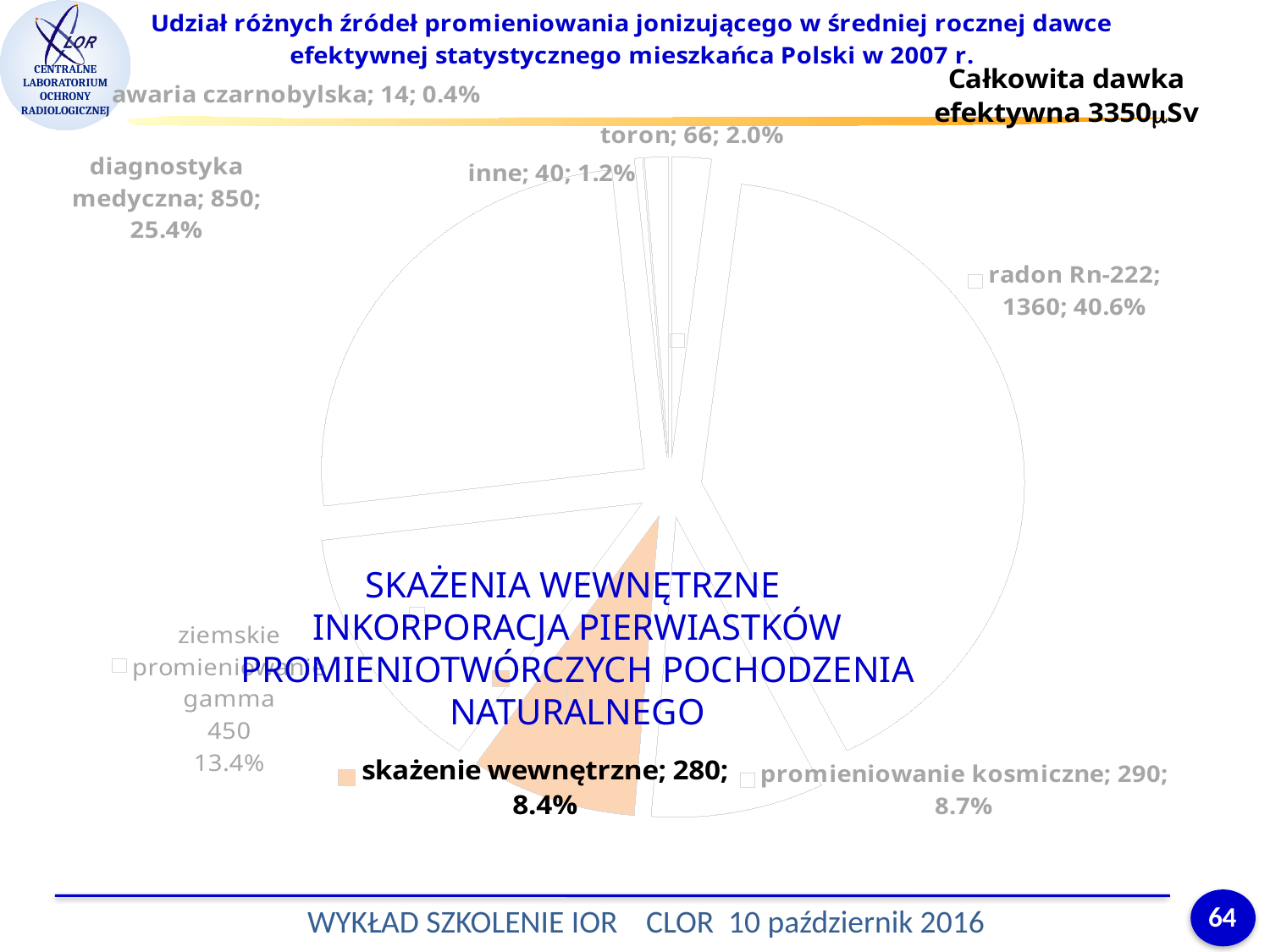
What value is shown for ziemskie promieniowanie gamma? 450 What value is shown for skażenie wewnętrzne? 280 Which is larger, the value for toron or the value for inne? toron Which category has the largest share of the pie? radon Rn-222 What kind of chart is shown on the slide? pie chart Which category has the smallest share of the pie? awaria czarnobylska What value is shown for radon Rn-222? 1360 What is the difference between the values for radon Rn-222 and diagnostyka medyczna? 510 What percentage share is shown for promieniowanie kosmiczne? 8.7% How many categories does the pie chart show? 8 What percentage share is shown for diagnostyka medyczna? 25.4% What total effective dose (Całkowita dawka efektywna) is stated on the slide? 3350 μSv